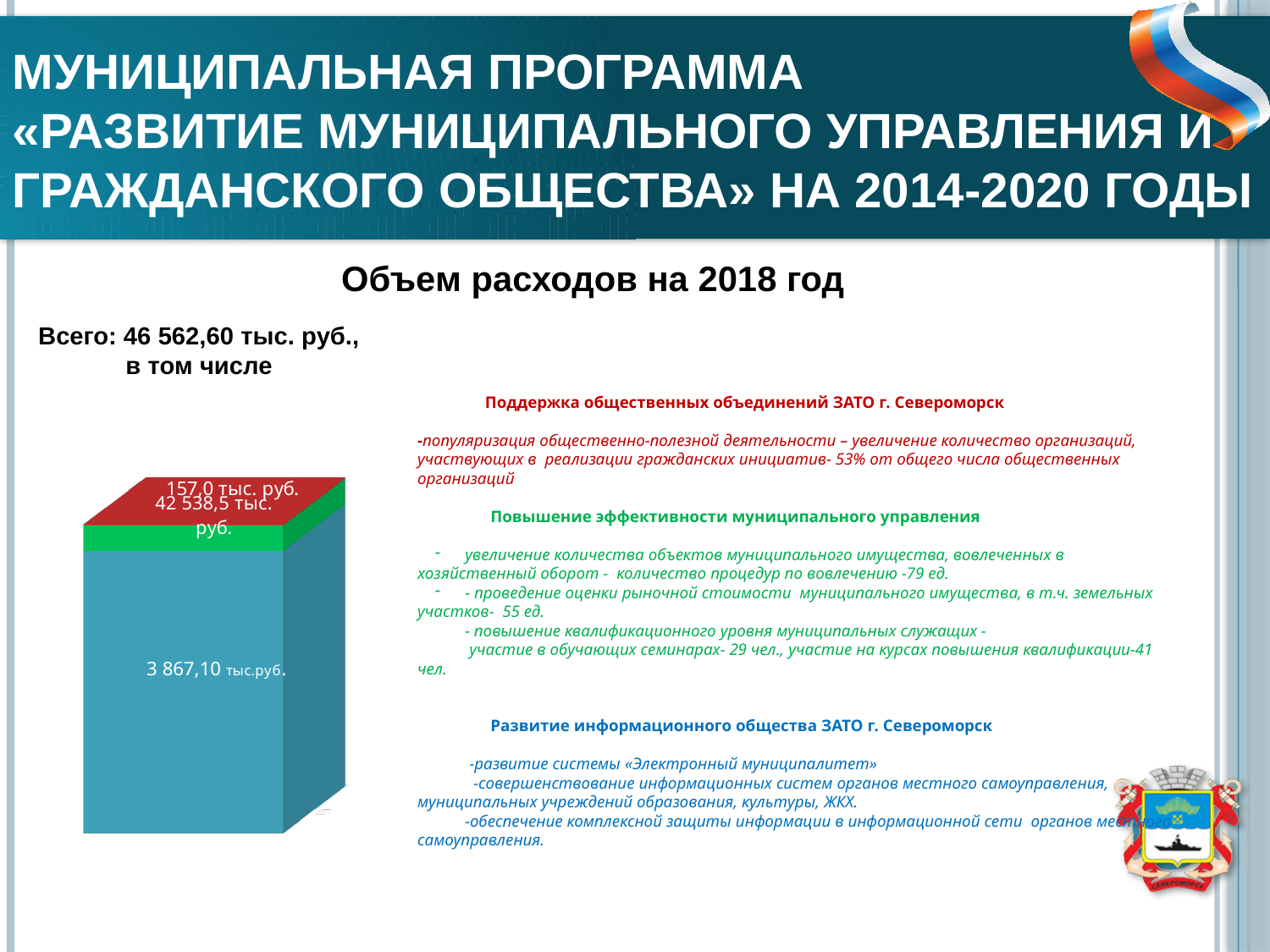
How many segments make up the stacked bar on the chart? 3 Which is larger, the value 42 538,5 тыс. руб. or the value 3 867,10 тыс. руб.? 42 538,5 тыс. руб. What three colours are used for the segments of the stacked bar? Red, green and blue What value is printed on the red top segment of the bar? 157,0 тыс. руб. What is the difference between the values 3 867,10 and 157,0 printed on the chart? 3 710,10 What value is printed on the blue segment of the bar? 3 867,10 тыс.руб. What is the smallest value printed on the chart? 157,0 тыс. руб. What is the total of the stacked bar, as stated on the slide? 46 562,60 тыс. руб. What is the largest value printed on the chart? 42 538,5 тыс. руб. What kind of chart is shown on the slide? Stacked bar chart What is the title above the chart? Объем расходов на 2018 год What is the difference between the values 42 538,5 and 3 867,10 printed on the chart? 38 671,4